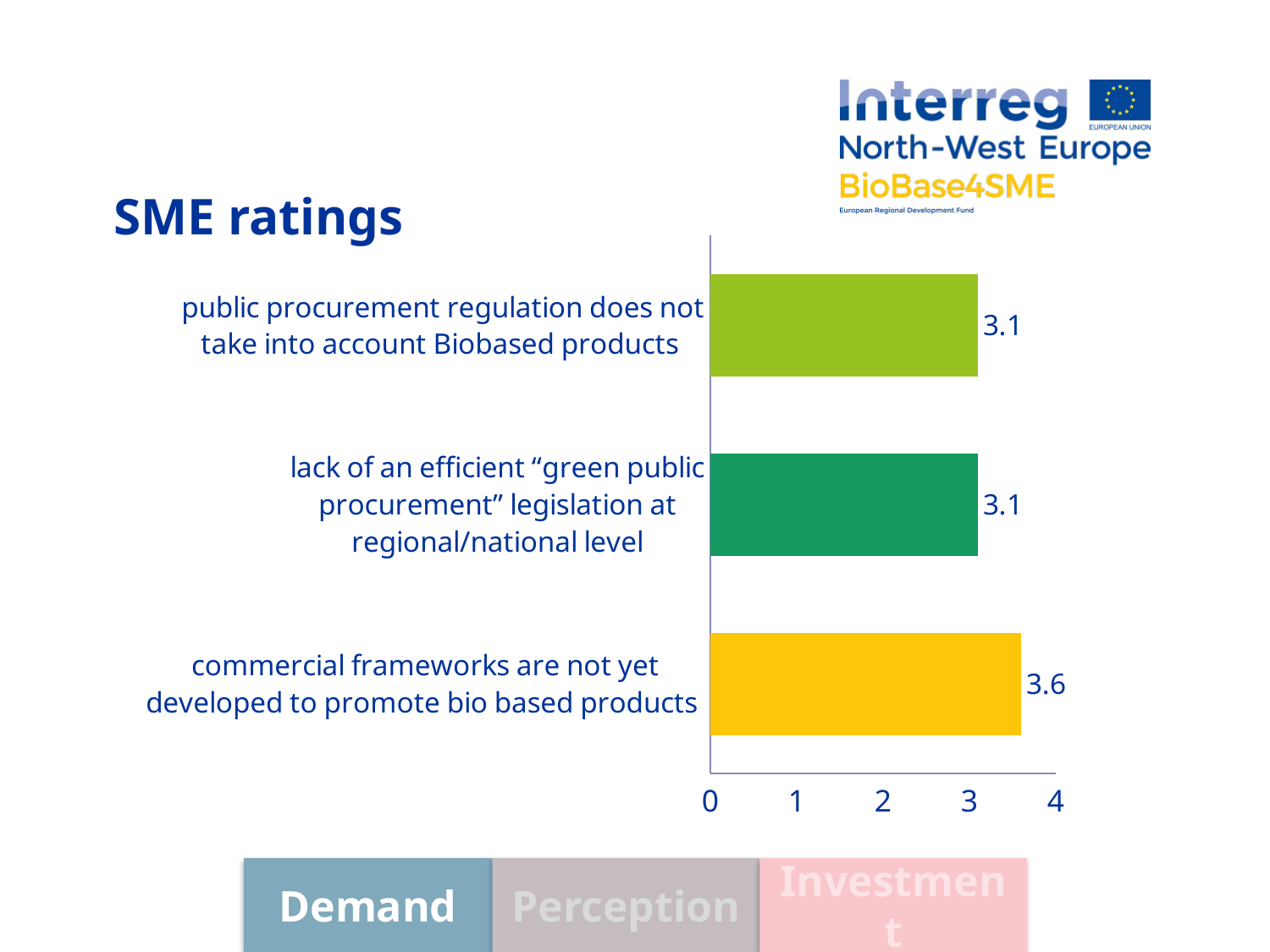
Which has a larger rating: 'commercial frameworks are not yet developed to promote bio based products' or 'lack of an efficient "green public procurement" legislation at regional/national level'? commercial frameworks are not yet developed to promote bio based products What is the maximum value shown on the chart's horizontal axis? 4 What is the difference between the rating for 'commercial frameworks are not yet developed to promote bio based products' and the rating for 'public procurement regulation does not take into account Biobased products'? 0.5 Which category has the highest SME rating? commercial frameworks are not yet developed to promote bio based products What is the SME rating for 'public procurement regulation does not take into account Biobased products'? 3.1 How many categories are shown in the chart? 3 What colour is the bar for 'commercial frameworks are not yet developed to promote bio based products'? yellow Is the rating for 'public procurement regulation does not take into account Biobased products' greater or less than 3? greater What kind of chart is shown on the slide? bar chart What is the SME rating for 'lack of an efficient "green public procurement" legislation at regional/national level'? 3.1 What is the SME rating for 'commercial frameworks are not yet developed to promote bio based products'? 3.6 Is the rating for 'commercial frameworks are not yet developed to promote bio based products' greater or less than 4? less